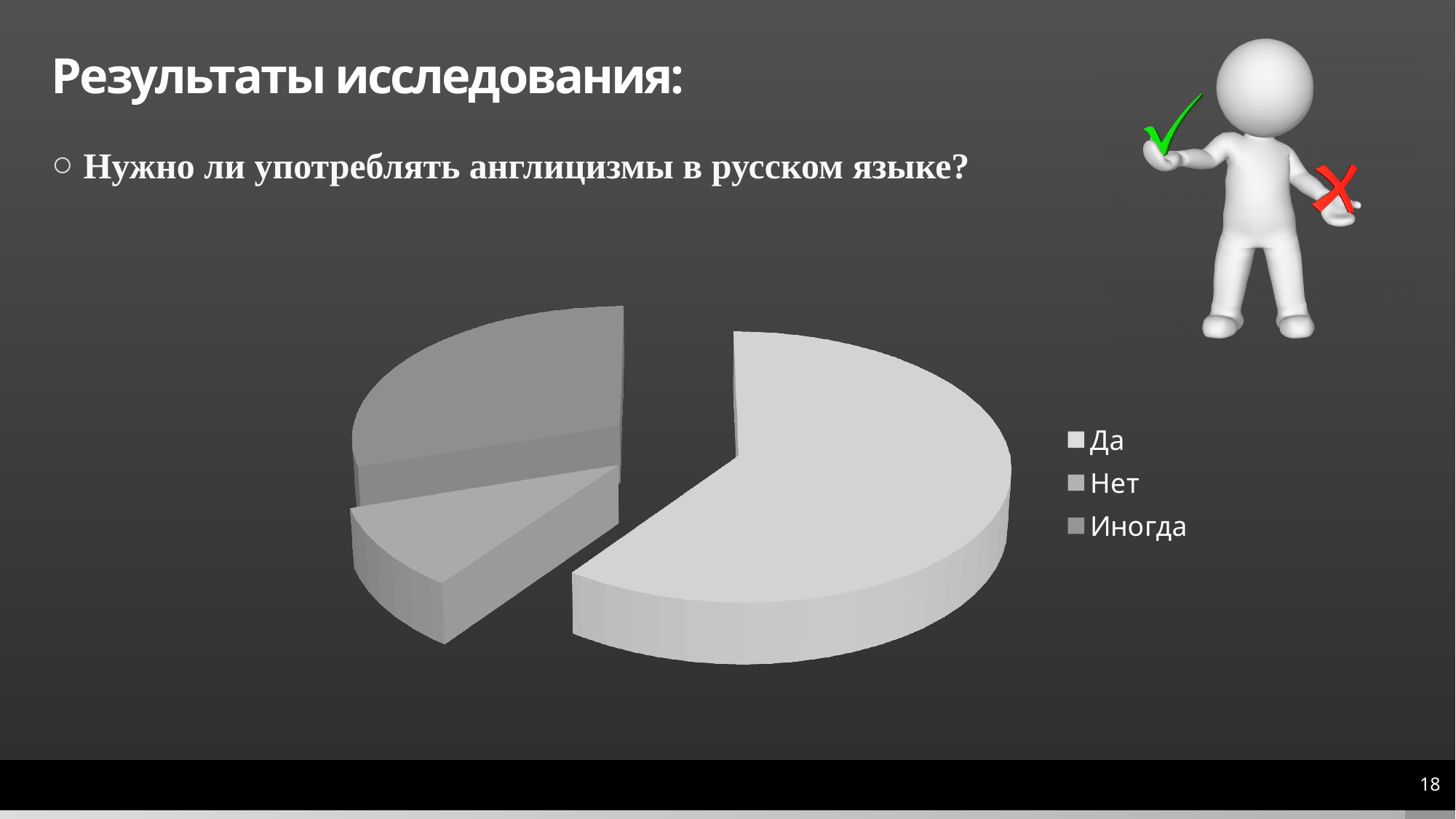
What kind of chart is shown on the slide? pie chart Which category has the largest slice in the pie chart? Да Does the Да slice take up more or less than half of the pie chart? more Which slice is larger in the pie chart, Да or Иногда? Да How many slices does the pie chart have? 3 Which slice is larger in the pie chart, Иногда or Нет? Иногда How many entries does the legend of the pie chart list? 3 Which slice is larger in the pie chart, Нет or Да? Да Which category has the smallest slice in the pie chart? Нет What are the legend entries of the pie chart, from top to bottom? Да, Нет, Иногда What survey question does the pie chart on the slide present results for? Нужно ли употреблять англицизмы в русском языке?